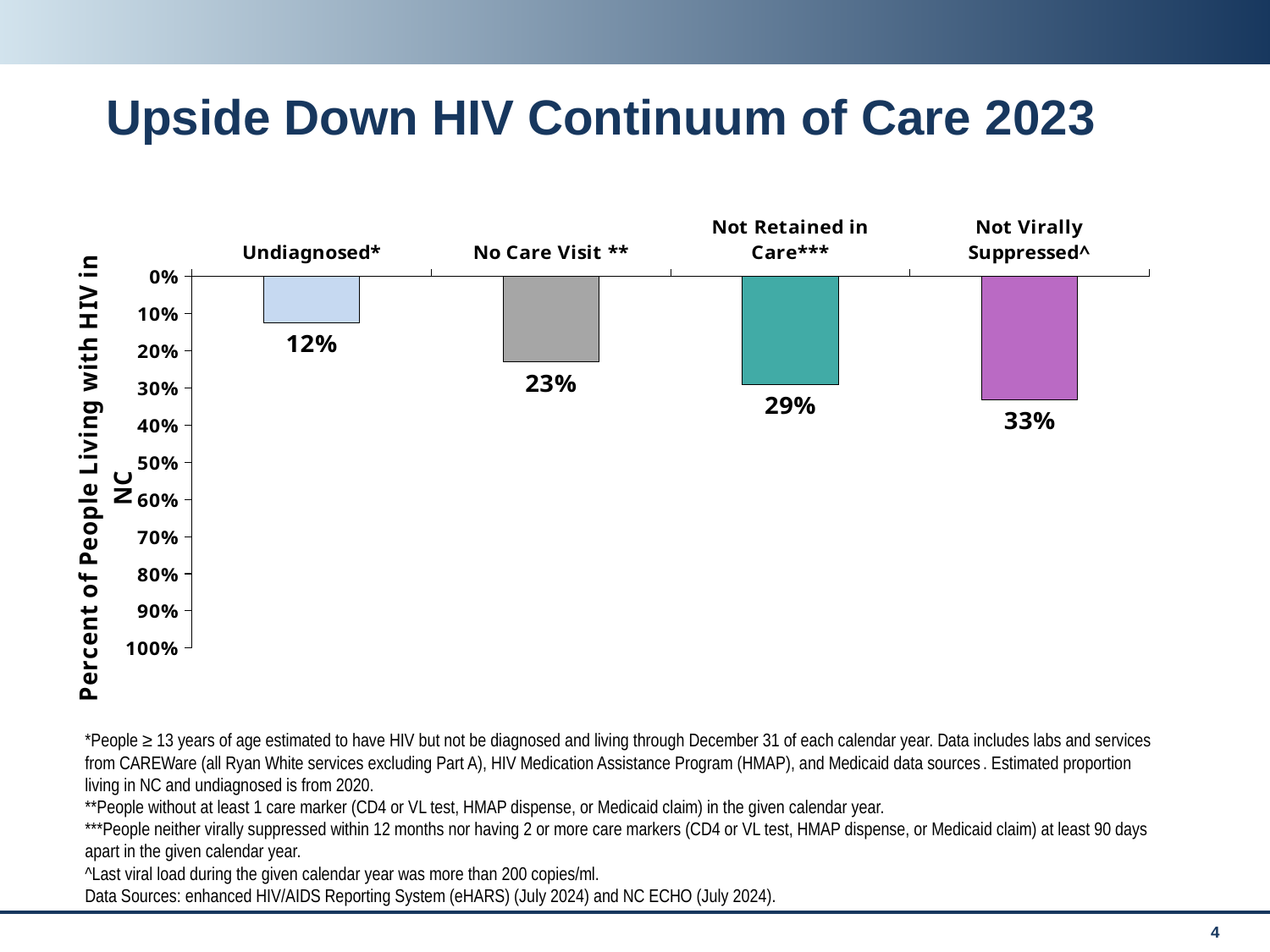
What kind of chart is shown on the slide? Bar chart What is the difference between the values for Not Virally Suppressed^ and Undiagnosed*? 21% What is the value for Not Retained in Care***? 29% Which is larger, the value for No Care Visit ** or the value for Not Retained in Care***? Not Retained in Care*** Which category has the lowest value? Undiagnosed* Do the values rise or fall from left to right across the categories? Rise What is the value for No Care Visit **? 23% What is the value for Undiagnosed*? 12% What is the value for Not Virally Suppressed^? 33% Which category has the highest value? Not Virally Suppressed^ What is the difference between the values for Not Retained in Care*** and No Care Visit **? 6% How many categories are shown in the chart? 4